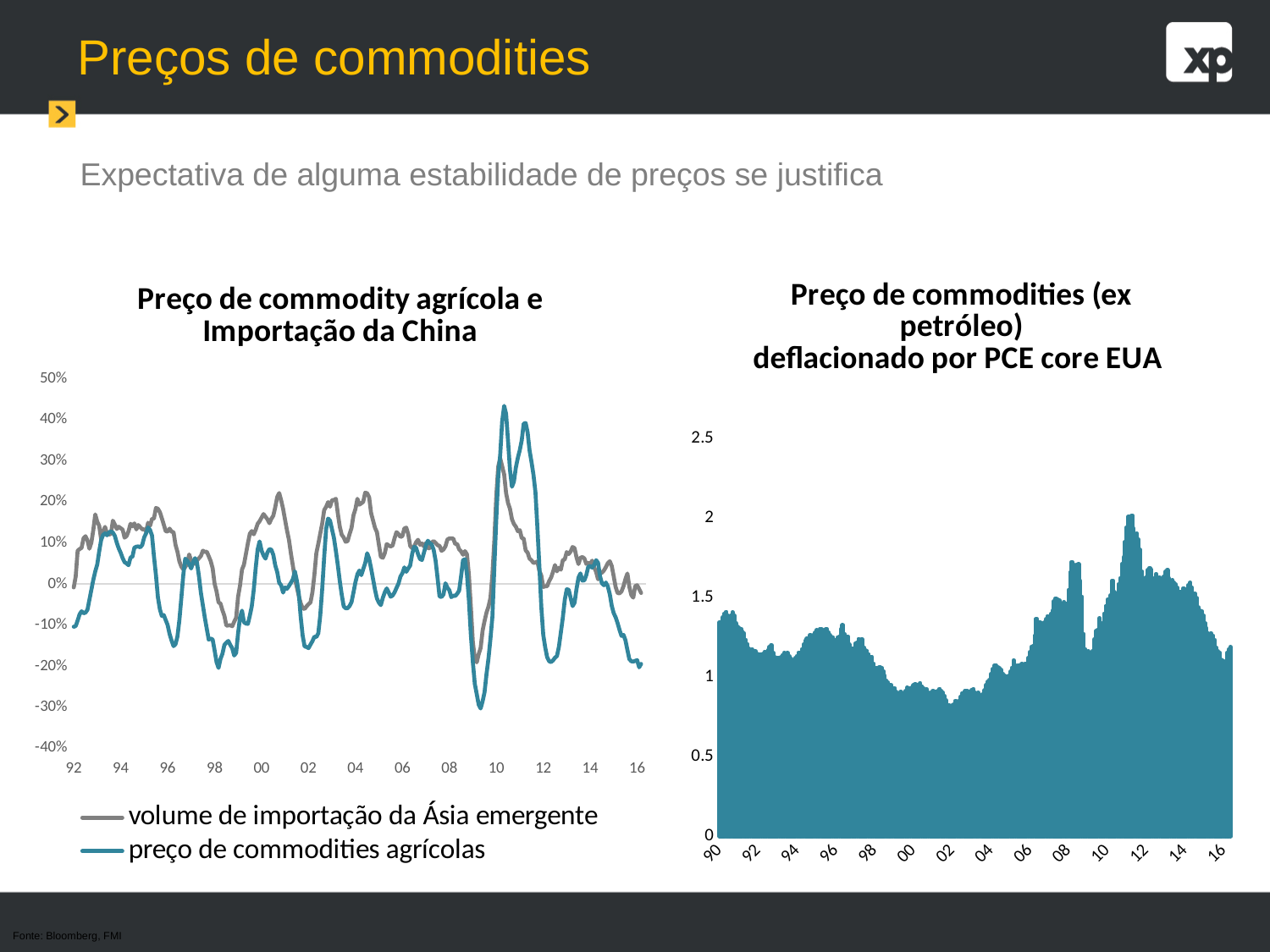
In the left chart, is the peak value of 'preço de commodities agrícolas' around 2010 greater or less than 30%? greater In the left chart, which series reaches the higher peak around 2010–2011, 'volume de importação da Ásia emergente' or 'preço de commodities agrícolas'? preço de commodities agrícolas What is the highest value shown on the y axis of the right chart? 2.5 In the left chart, is the lowest value of 'preço de commodities agrícolas' around 2009 greater or less than -20%? less In the right chart, is the value around 2002 greater or less than 1? less In the left chart, what are the two series named in the legend? volume de importação da Ásia emergente; preço de commodities agrícolas In the right chart, do the values rise or fall between 2011 and 2016? fall What kind of chart is the left chart titled 'Preço de commodity agrícola e Importação da China'? line chart What kind of chart is the right chart titled 'Preço de commodities (ex petróleo) deflacionado por PCE core EUA'? area chart In the left chart, does 'preço de commodities agrícolas' rise or fall between 2014 and 2016? fall How many series does the legend of the left chart list? 2